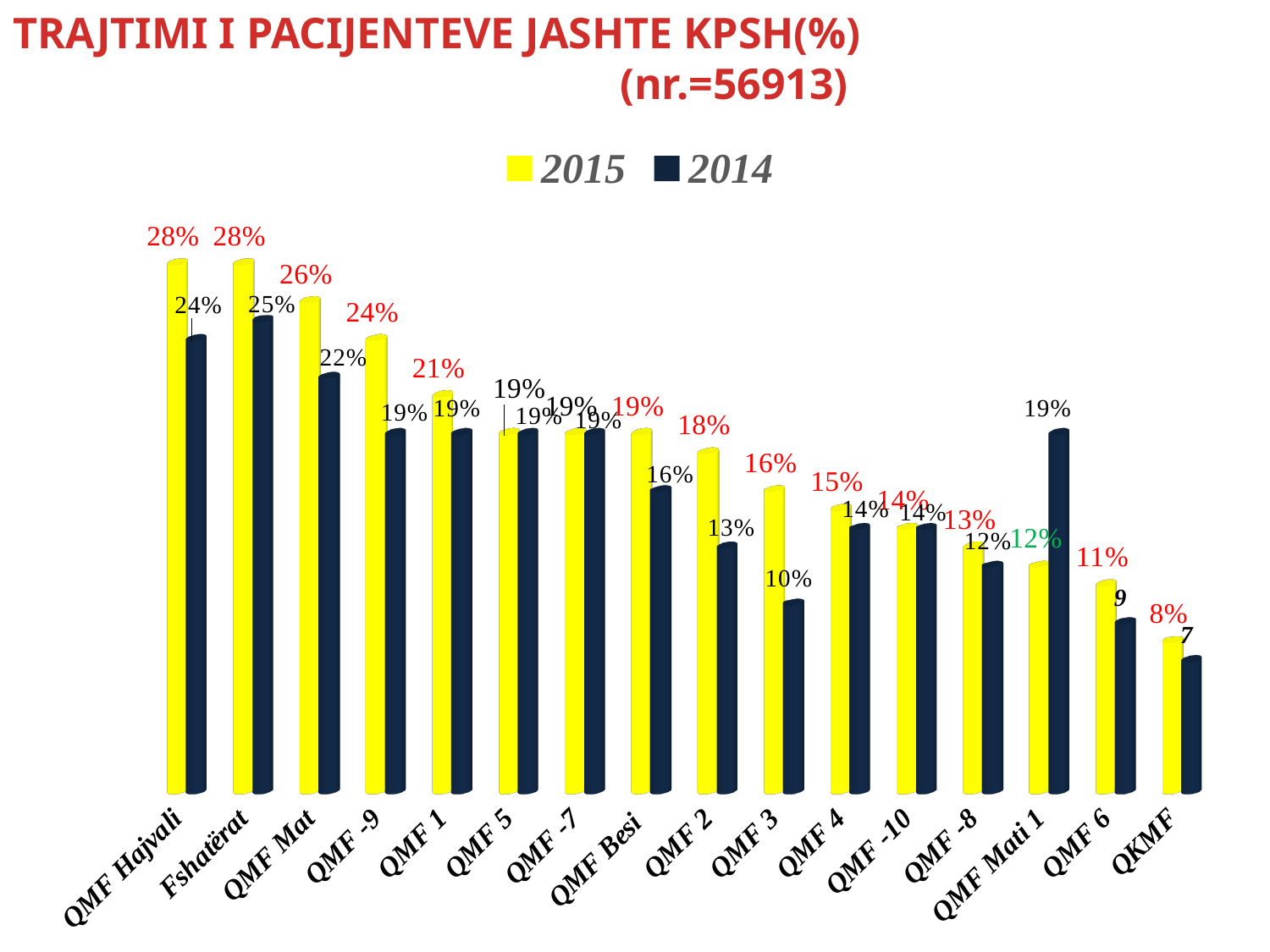
Which category has the lowest 2015 value? QKMF How many categories are shown on the x axis? 16 For QMF Mati 1, which year has the larger value, 2015 or 2014? 2014 Which category has the highest 2014 value? Fshatërat What kind of chart is shown on the slide? Bar chart What is the 2014 value for QMF Hajvali? 24% What is the difference between the 2015 and 2014 values for QMF 3? 6 percentage points How many series does the legend list? 2 What is the 2015 value for QMF 3? 16% What is the 2015 value for QMF Mat? 26% Which colour represents the 2015 series in the legend? Yellow What is the 2014 value for QMF Mati 1? 19%